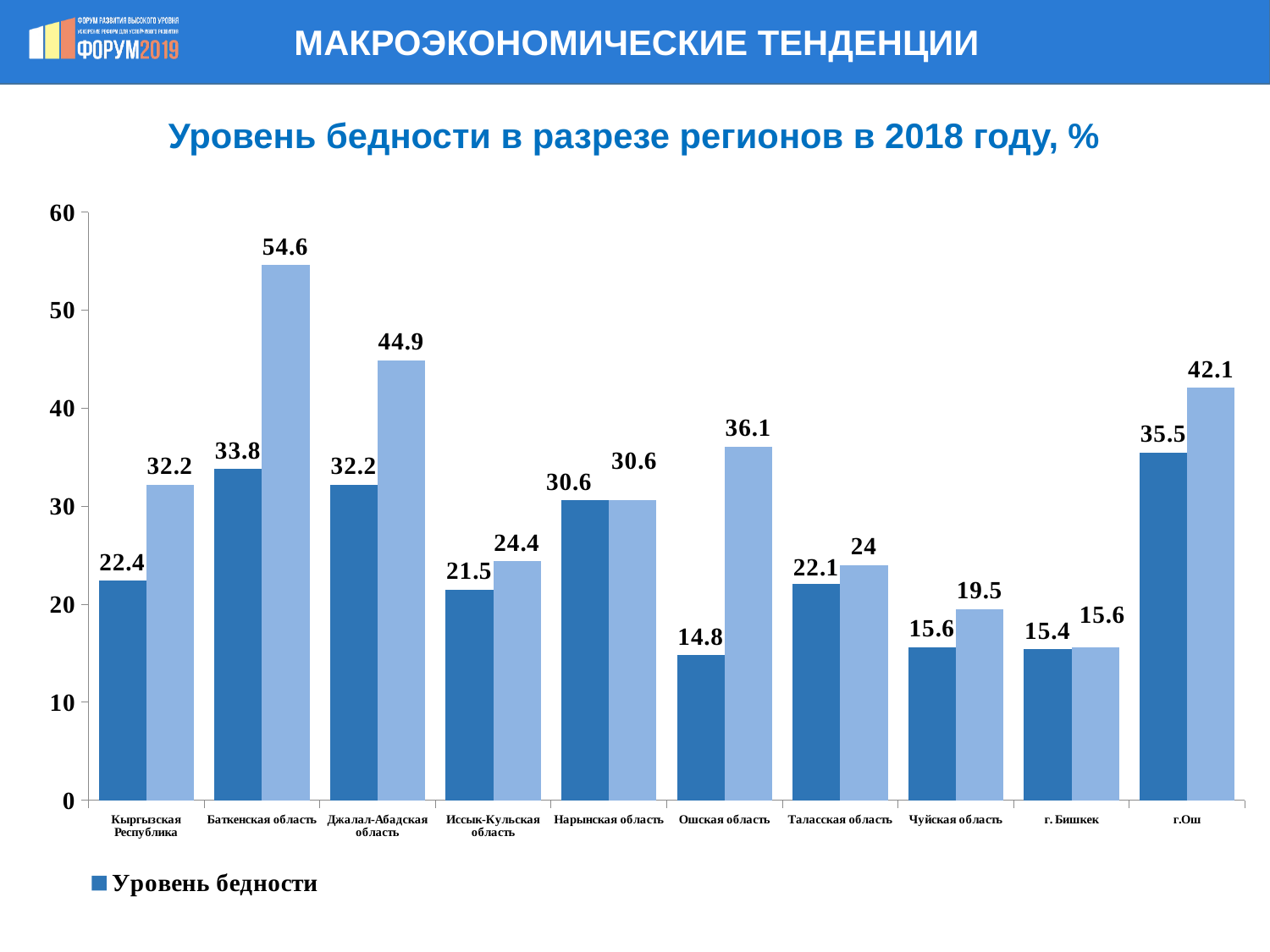
What is the difference between the light blue bar and the dark blue bar for Баткенская область? 20.8 Is the light blue bar for Джалал-Абадская область greater or less than 40? greater How many regions (categories) are shown on the x axis? 10 How many series does the legend list? 1 What is the value of the dark blue "Уровень бедности" bar for Баткенская область? 33.8 What type of chart is shown on the slide? Bar chart Which region has the lowest dark blue "Уровень бедности" bar? Ошская область Which region has the highest dark blue "Уровень бедности" bar? г.Ош Which is larger: the dark blue "Уровень бедности" bar for Джалал-Абадская область or for Нарынская область? Джалал-Абадская область What is the value of the dark blue "Уровень бедности" bar for Ошская область? 14.8 Which region has the highest light blue bar? Баткенская область What is the value of the light blue bar for г.Ош? 42.1